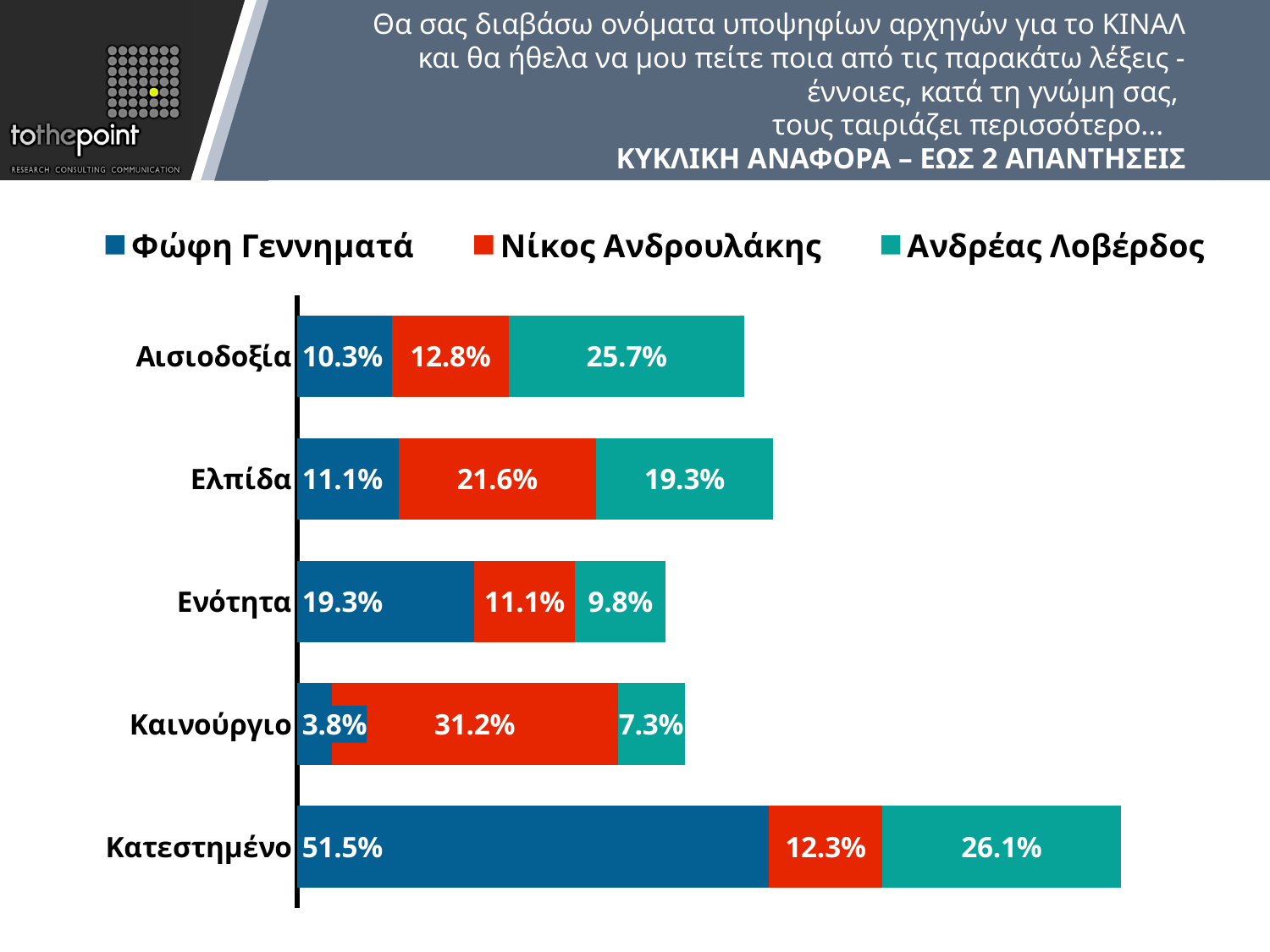
What is the total of the stacked bar for Κατεστημένο? 89.9% What is the value for Νίκος Ανδρουλάκης in the Καινούργιο category? 31.2% What is the value for Φώφη Γεννηματά in the Κατεστημένο category? 51.5% What kind of chart is shown on the slide? Stacked bar chart What is the value for Ανδρέας Λοβέρδος in the Αισιοδοξία category? 25.7% In which category does Φώφη Γεννηματά have the highest value? Κατεστημένο Which is larger in the Ενότητα category: the value for Φώφη Γεννηματά or the value for Ανδρέας Λοβέρδος? Φώφη Γεννηματά What is the difference between the values for Νίκος Ανδρουλάκης and Φώφη Γεννηματά in the Ελπίδα category? 10.5% In which category does Ανδρέας Λοβέρδος have the lowest value? Καινούργιο How many series does the legend list? 3 Which colour represents Νίκος Ανδρουλάκης in the chart? Red How many categories are shown on the chart? 5